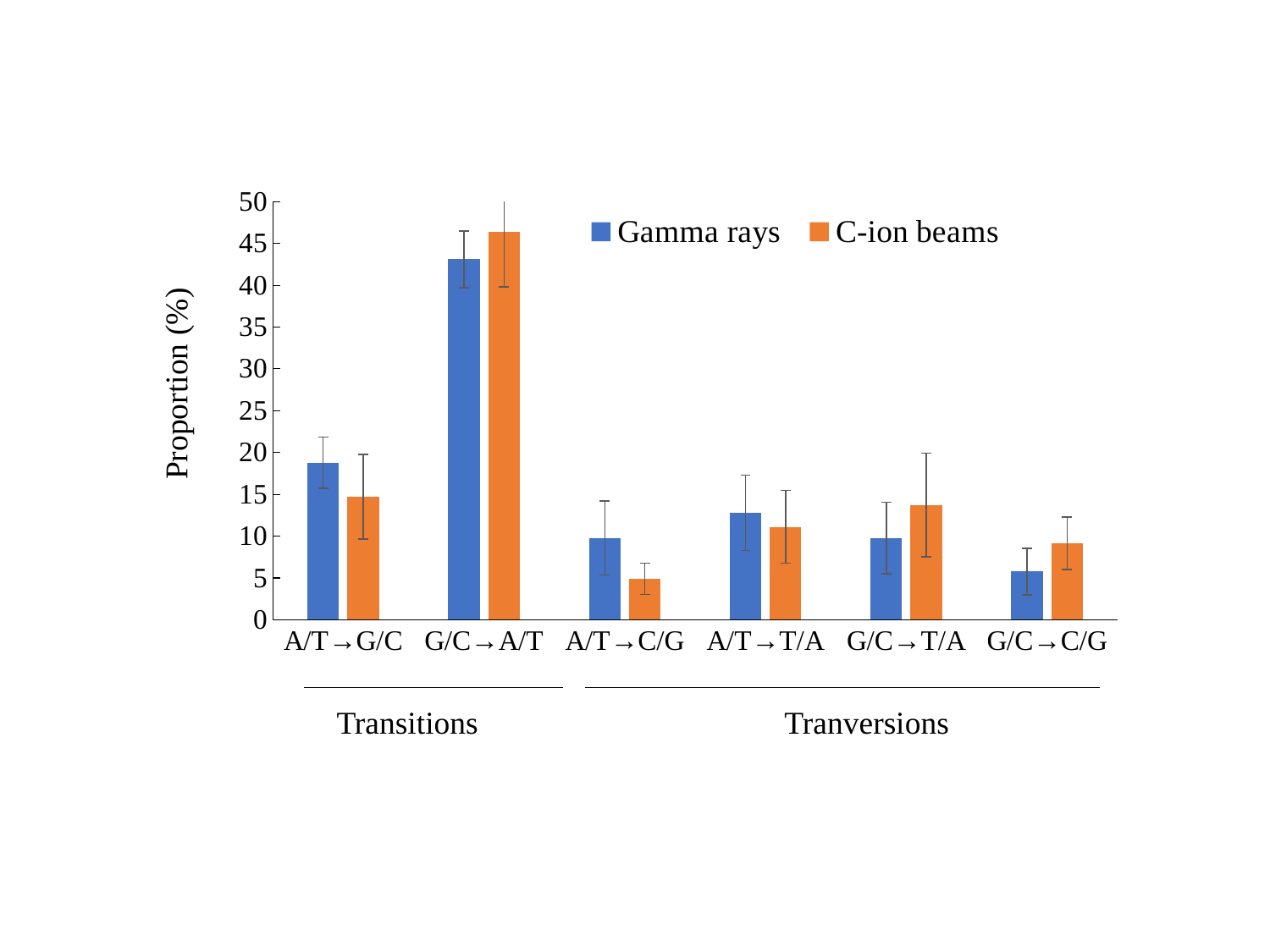
Which category has the highest value for C-ion beams? G/C→A/T For G/C→T/A, which series has the larger value, Gamma rays or C-ion beams? C-ion beams For A/T→G/C, which series has the larger value, Gamma rays or C-ion beams? Gamma rays Which category has the highest value for Gamma rays? G/C→A/T Which category has the lowest value for Gamma rays? G/C→C/G What is the label of the y axis? Proportion (%) What kind of chart is shown on the slide? bar chart How many series does the legend list? 2 Which category has the lowest value for C-ion beams? A/T→C/G Is the C-ion beams value for A/T→C/G greater or less than 10? less Is the Gamma rays value for G/C→A/T greater or less than 40? greater How many mutation categories are shown along the x axis? 6